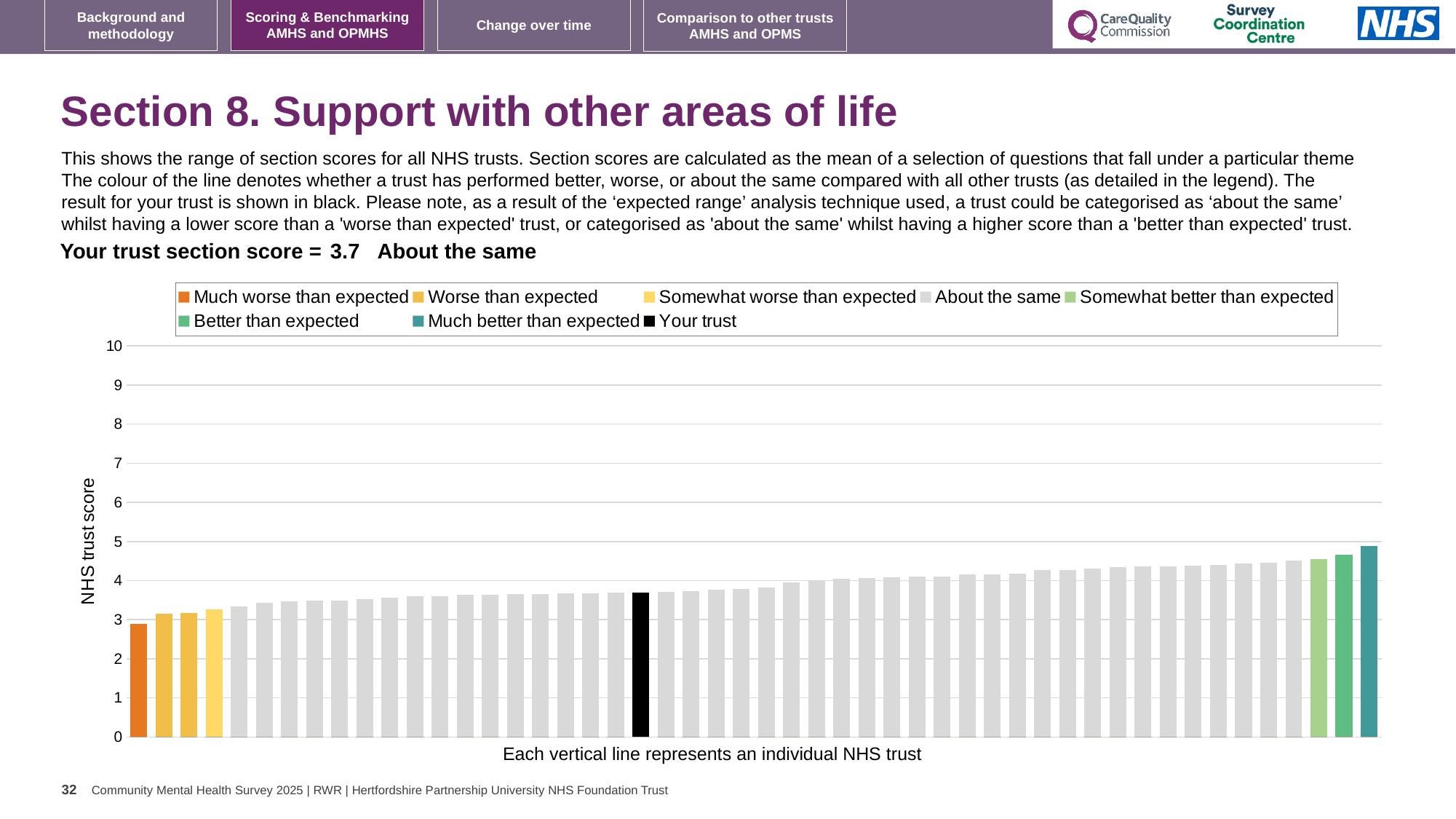
Which category is your trust placed in for this section? About the same Is the value of the shortest bar in the chart greater or less than 2? greater What kind of chart is shown on the slide? bar chart Is the value of the tallest bar in the chart greater or less than 4? greater Do the bar values rise or fall from left to right along the x axis? rise Which legend category does the shortest bar in the chart belong to? Much worse than expected What is the section score for your trust shown on the slide? 3.7 What is the title of the vertical axis of the chart? NHS trust score How many entries does the chart legend list? 8 Is the value of the black 'Your trust' bar greater or less than 3? greater Which legend category does the tallest bar in the chart belong to? Much better than expected